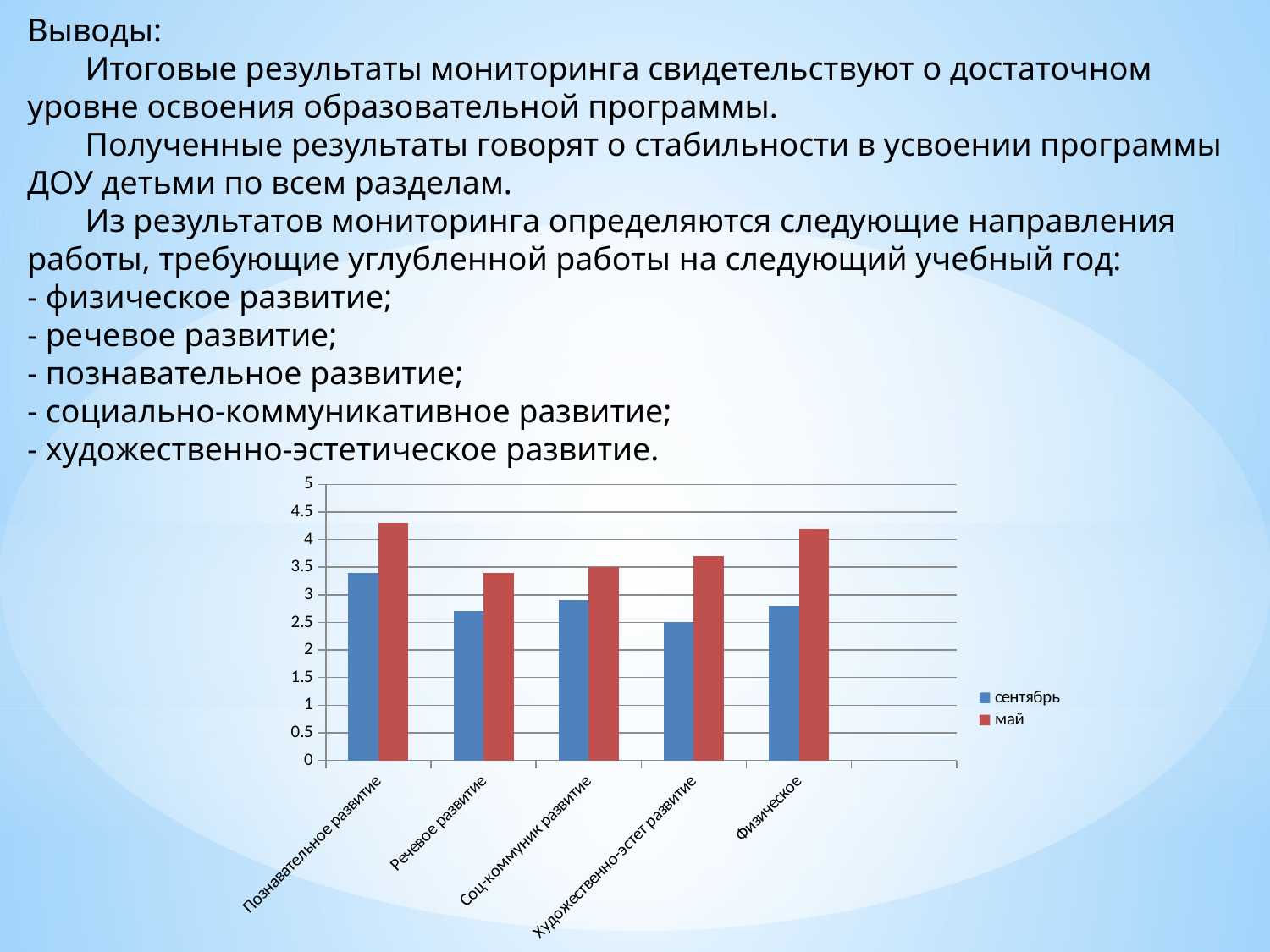
Is the value for май in Физическое greater or less than 4? greater In Художественно-эстет развитие, which series has the larger value, сентябрь or май? май How many categories are shown on the x axis of the chart? 5 Which category has the highest value for сентябрь? Познавательное развитие What kind of chart is shown on the slide? bar chart Is the value for сентябрь in Физическое greater or less than 3? less Which is larger: the май value for Познавательное развитие or the май value for Речевое развитие? Познавательное развитие Is the value for май in Познавательное развитие greater or less than 4? greater What are the two series named in the legend? сентябрь and май How many series does the legend list? 2